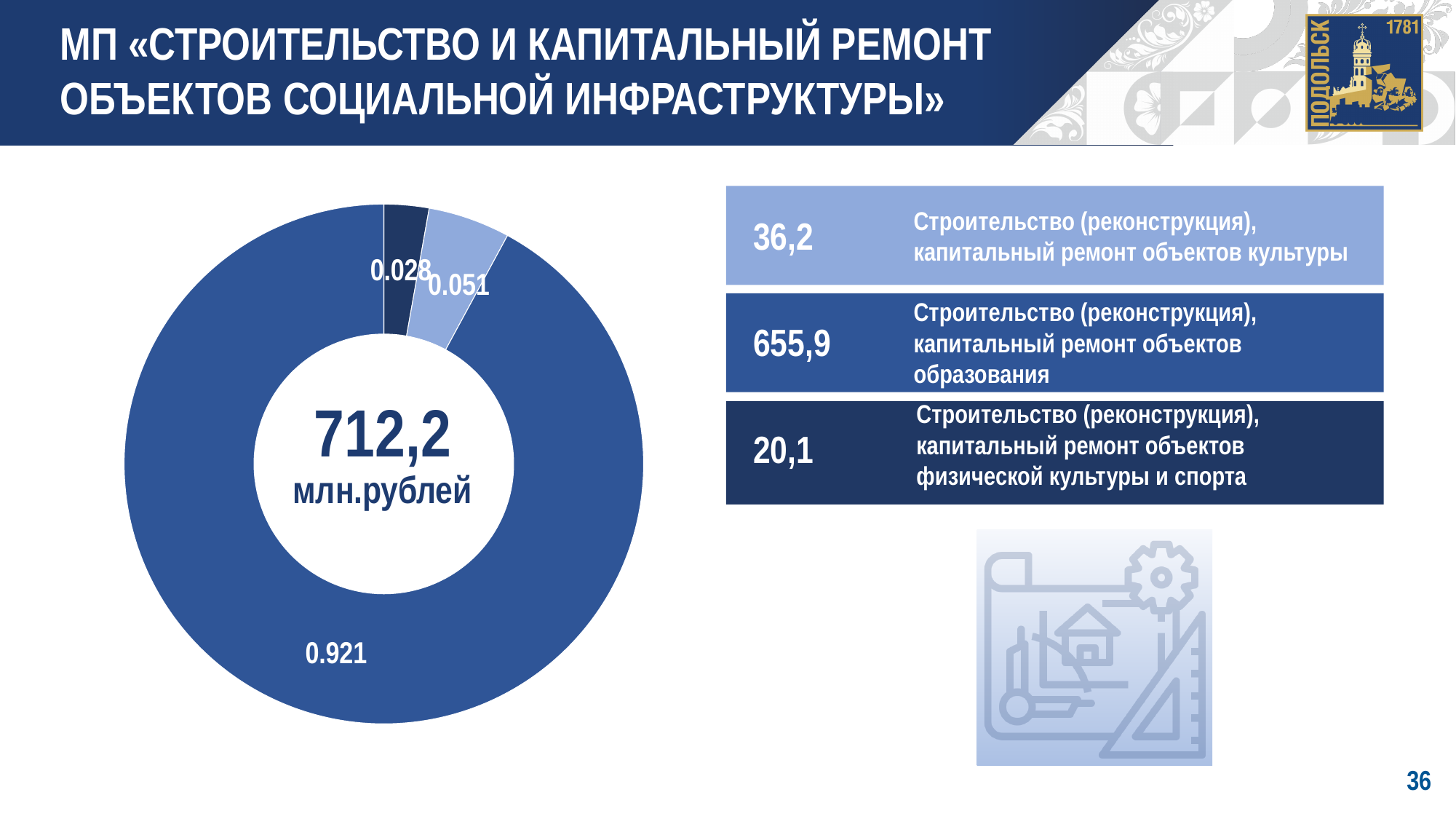
How many slices does the donut chart have? 3 What is the difference between the value for объекты культуры (36,2) and объекты физической культуры и спорта (20,1)? 16,1 Which category has the largest value? Строительство (реконструкция), капитальный ремонт объектов образования Which category has the smallest value? Строительство (реконструкция), капитальный ремонт объектов физической культуры и спорта What is the value for «Строительство (реконструкция), капитальный ремонт объектов культуры»? 36,2 What share label is shown on the dark navy slice (объекты физической культуры и спорта)? 0.028 What kind of chart is shown on the slide? Donut (pie) chart What share of the donut chart is labelled for the largest slice (объекты образования)? 0.921 Which is larger: the value for объекты культуры or for объекты физической культуры и спорта? объекты культуры What share label is shown on the light blue slice (объекты культуры)? 0.051 What is the value for «Строительство (реконструкция), капитальный ремонт объектов образования»? 655,9 What total value is printed in the centre of the donut chart? 712,2 млн.рублей